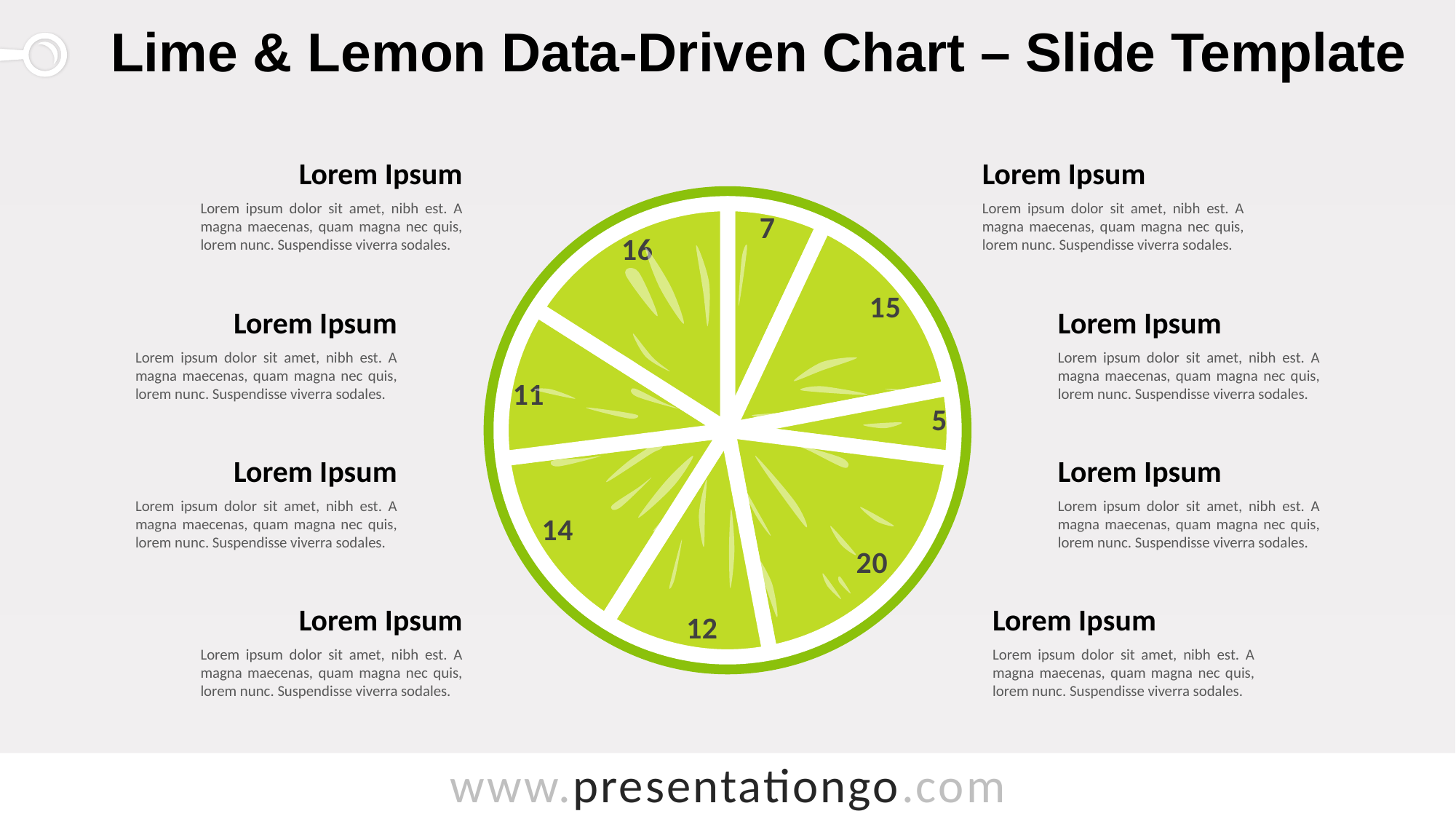
What is the title of the slide containing the pie chart? Lime & Lemon Data-Driven Chart – Slide Template What share of the whole pie does the slice labelled 20 represent? 20% What value is labelled on the slice at the bottom of the pie chart? 12 What share of the whole pie does the slice labelled 5 represent? 5% What is the difference between the largest and smallest slice values on the pie chart? 15 What is the smallest value labelled on the pie chart? 5 What is the total of all the slice values shown on the pie chart? 100 What is the largest value labelled on the pie chart? 20 What value is labelled on the slice at the far right of the pie chart? 5 How many slices does the pie chart have? 8 What kind of chart is shown on the slide? pie chart Which is larger on the pie chart: the slice labelled 16 or the slice labelled 15? 16